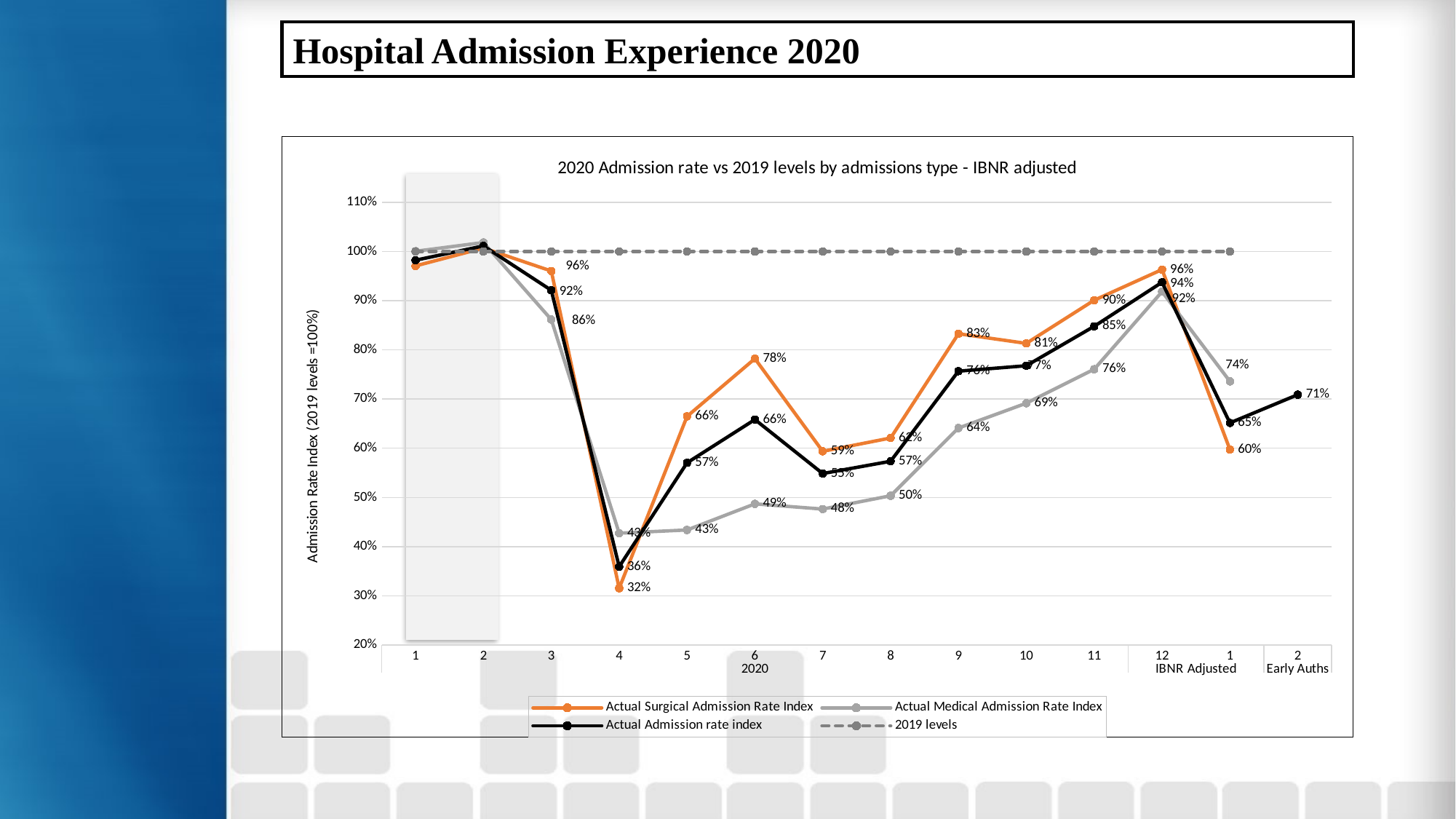
How many series does the legend list? 4 What is the Actual Medical Admission Rate Index value at '1 IBNR Adjusted'? 74% What is the Actual Admission rate index value at month 3? 92% What is the Actual Admission rate index value at '2 Early Auths'? 71% What is the Actual Medical Admission Rate Index value at month 11? 76% What is the Actual Surgical Admission Rate Index value at month 6? 78% At month 4, which series has the lowest value? Actual Surgical Admission Rate Index At month 12, which is larger: the Actual Surgical Admission Rate Index or the Actual Medical Admission Rate Index? Actual Surgical Admission Rate Index What is the difference between the Actual Surgical Admission Rate Index and the Actual Medical Admission Rate Index at month 5? 23 percentage points Is the Actual Medical Admission Rate Index at month 1 greater or less than 90%? greater What type of chart is shown on the slide? Line chart At which month does the Actual Surgical Admission Rate Index reach its lowest value? 4